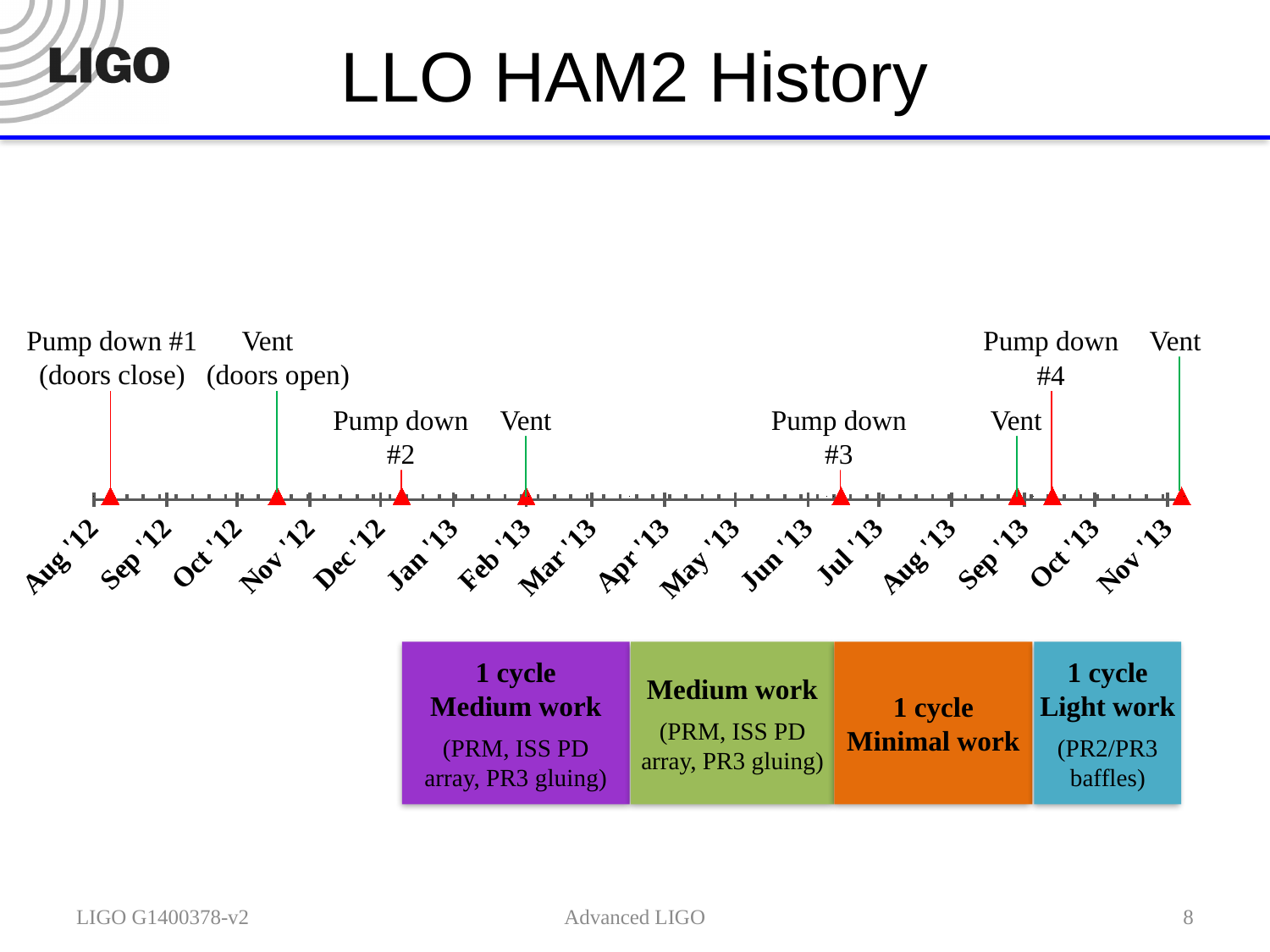
How many coloured work-description boxes are shown below the timeline? 4 What is the title of the chart on the slide? LLO HAM2 History What is the first month label on the timeline axis? Aug '12 How many vent events are marked on the timeline? 4 How many month labels are shown along the timeline axis? 16 At which month label is Pump down #1 (doors close) marked on the timeline? Aug '12 What kind of chart is shown on the slide? Timeline chart What is the last month label on the timeline axis? Nov '13 What work is described in the blue box below the timeline? 1 cycle Light work (PR2/PR3 baffles)